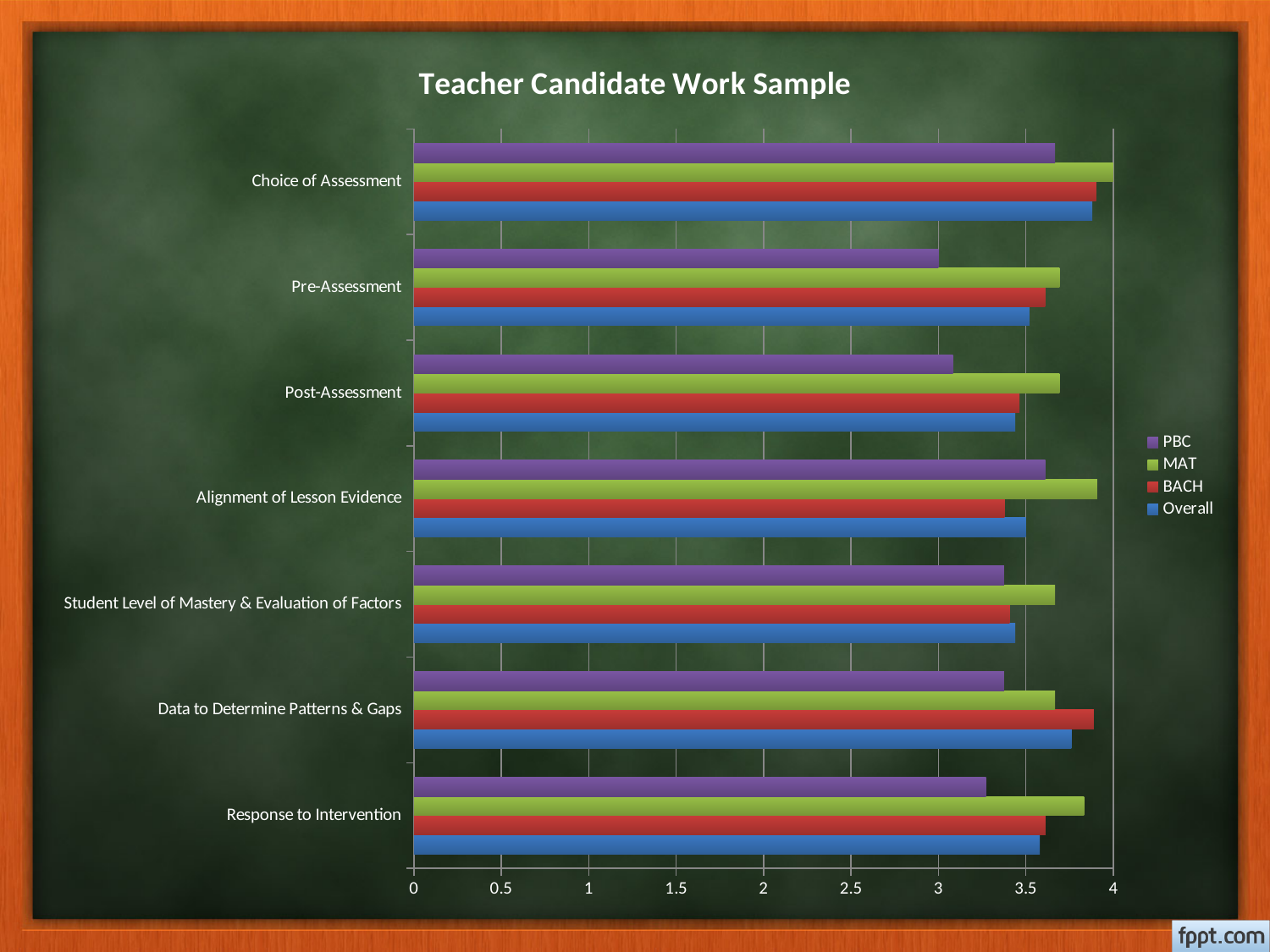
Is the MAT value for Choice of Assessment greater or less than 3.5? greater What kind of chart is shown on the slide? bar chart Which colour represents the MAT series in the legend? green Is the BACH value for Data to Determine Patterns & Gaps greater or less than 3.5? greater How many series does the legend list? 4 What is the title of the chart? Teacher Candidate Work Sample Is the PBC value for Response to Intervention greater or less than 3.5? less How many categories are shown on the vertical axis? 7 For Data to Determine Patterns & Gaps, which is larger: the BACH value or the PBC value? BACH Which category has the highest MAT value? Choice of Assessment For Pre-Assessment, which is larger: the PBC value or the MAT value? MAT